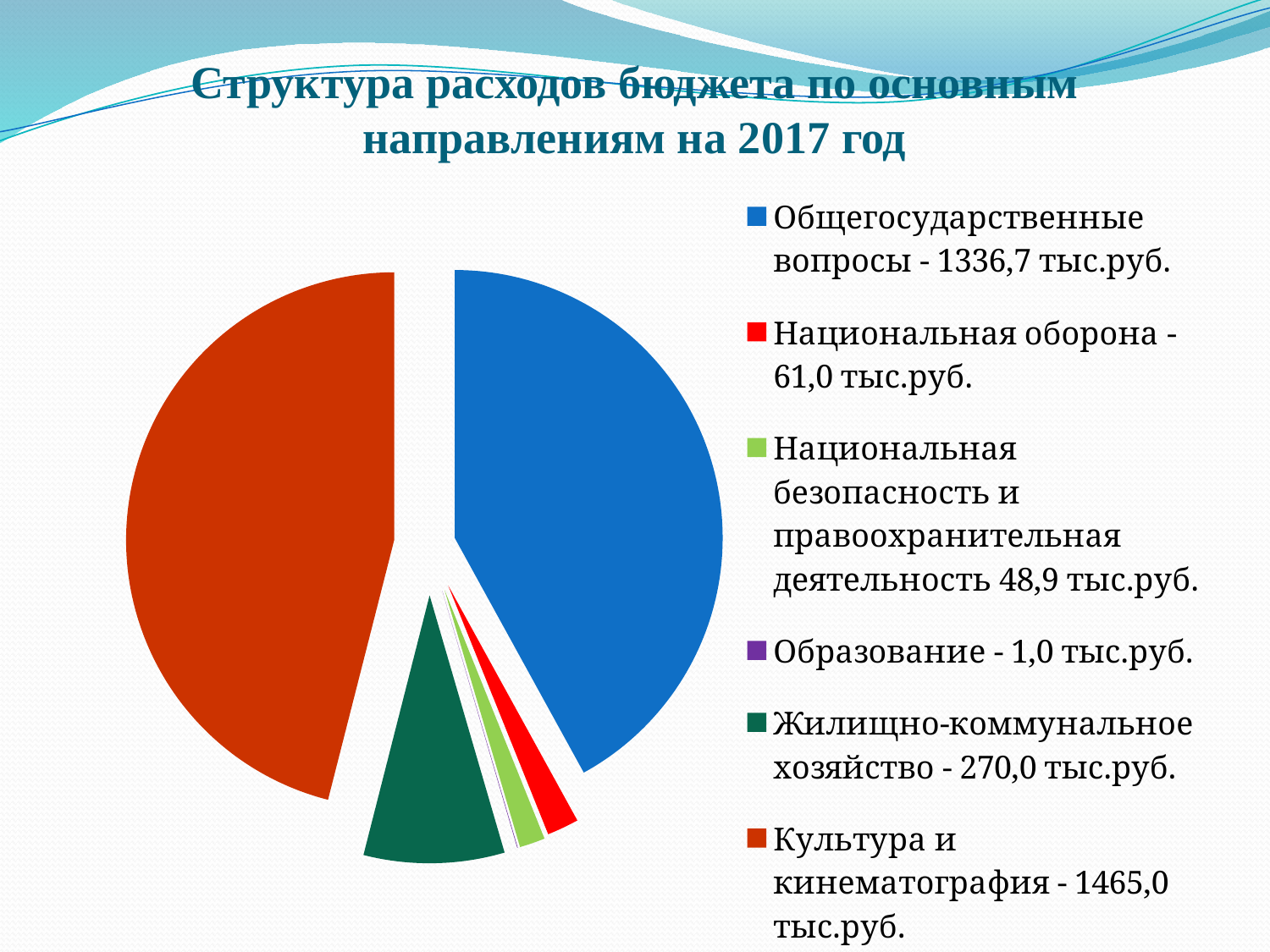
What is the value for Общегосударственные вопросы? 1336,7 тыс.руб. Which is larger: Национальная оборона or Национальная безопасность и правоохранительная деятельность? Национальная оборона What is the title of the slide? Структура расходов бюджета по основным направлениям на 2017 год What is the difference between Жилищно-коммунальное хозяйство and Национальная оборона? 209,0 тыс.руб. What is the value for Образование? 1,0 тыс.руб. Which category has the largest value? Культура и кинематография How many categories does the pie chart have? 6 What is the value for Жилищно-коммунальное хозяйство? 270,0 тыс.руб. What is the value for Национальная оборона? 61,0 тыс.руб. What kind of chart is shown on the slide? Pie chart What is the difference between Культура и кинематография and Общегосударственные вопросы? 128,3 тыс.руб. Which category has the smallest value? Образование